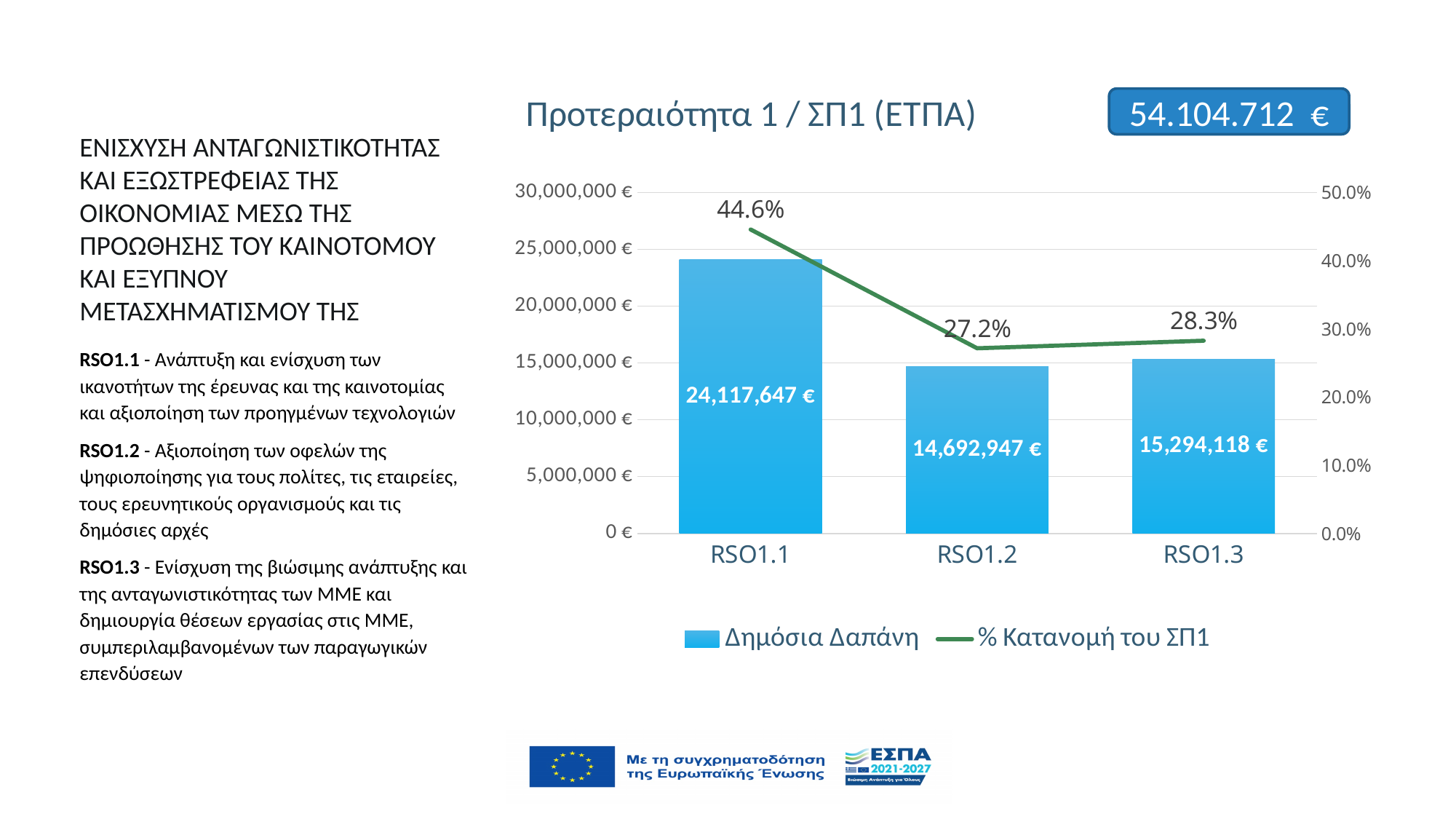
What is the difference in Δημόσια Δαπάνη between RSO1.1 and RSO1.2? 9,424,700 € Which has a larger Δημόσια Δαπάνη, RSO1.2 or RSO1.3? RSO1.3 Which category has the highest Δημόσια Δαπάνη? RSO1.1 What percentage (% Κατανομή του ΣΠ1) is shown for RSO1.1? 44.6% How many categories are shown on the x axis of the chart? 3 What is the difference in Δημόσια Δαπάνη between RSO1.3 and RSO1.2? 601,171 € What is the title of the chart? Προτεραιότητα 1 / ΣΠ1 (ΕΤΠΑ) How many series does the chart legend list? 2 Which category has the lowest Δημόσια Δαπάνη? RSO1.2 What is the Δημόσια Δαπάνη value for RSO1.1? 24,117,647 € What is the Δημόσια Δαπάνη value for RSO1.2? 14,692,947 € What percentage (% Κατανομή του ΣΠ1) is shown for RSO1.3? 28.3%